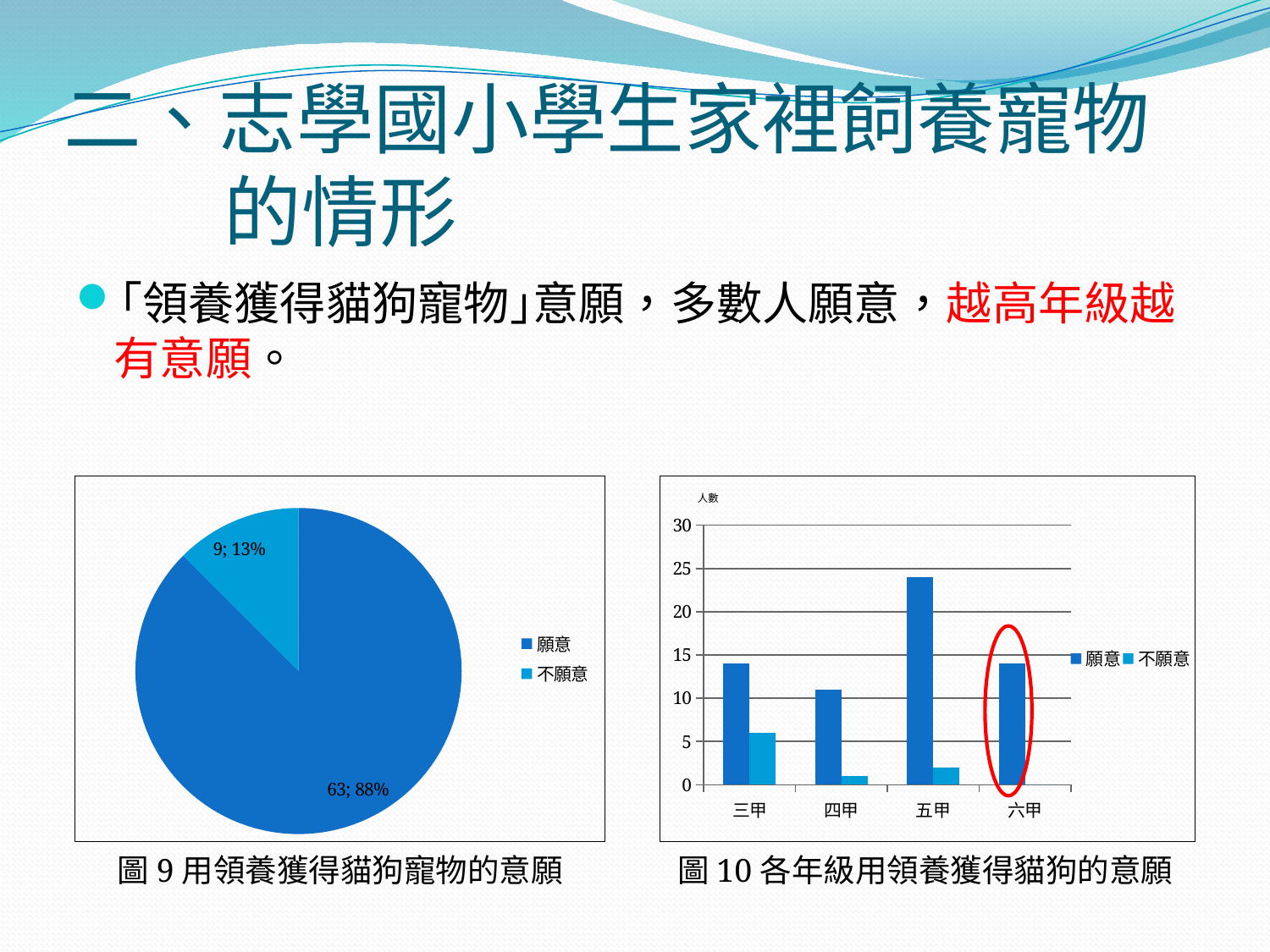
In the bar chart 圖 10, is the 願意 value for 五甲 greater or less than 20? greater In the pie chart 圖 9, what share of the pie does 不願意 take? 13% In the pie chart 圖 9, what is the data label shown for the 願意 slice? 63; 88% What kind of chart is 圖 9 on the left of the slide? pie chart In the bar chart 圖 10, what is the label on the y axis? 人數 What kind of chart is 圖 10 on the right of the slide? bar chart In the bar chart 圖 10, how many categories are shown on the x axis? 4 In the bar chart 圖 10, which category has the highest 願意 value? 五甲 In the pie chart 圖 9, which slice is larger, 願意 or 不願意? 願意 In the bar chart 圖 10, is the 不願意 value for 三甲 greater or less than 10? less In the pie chart 圖 9, what is the data label shown for the 不願意 slice? 9; 13% In the bar chart 圖 10, how many series does the legend list? 2